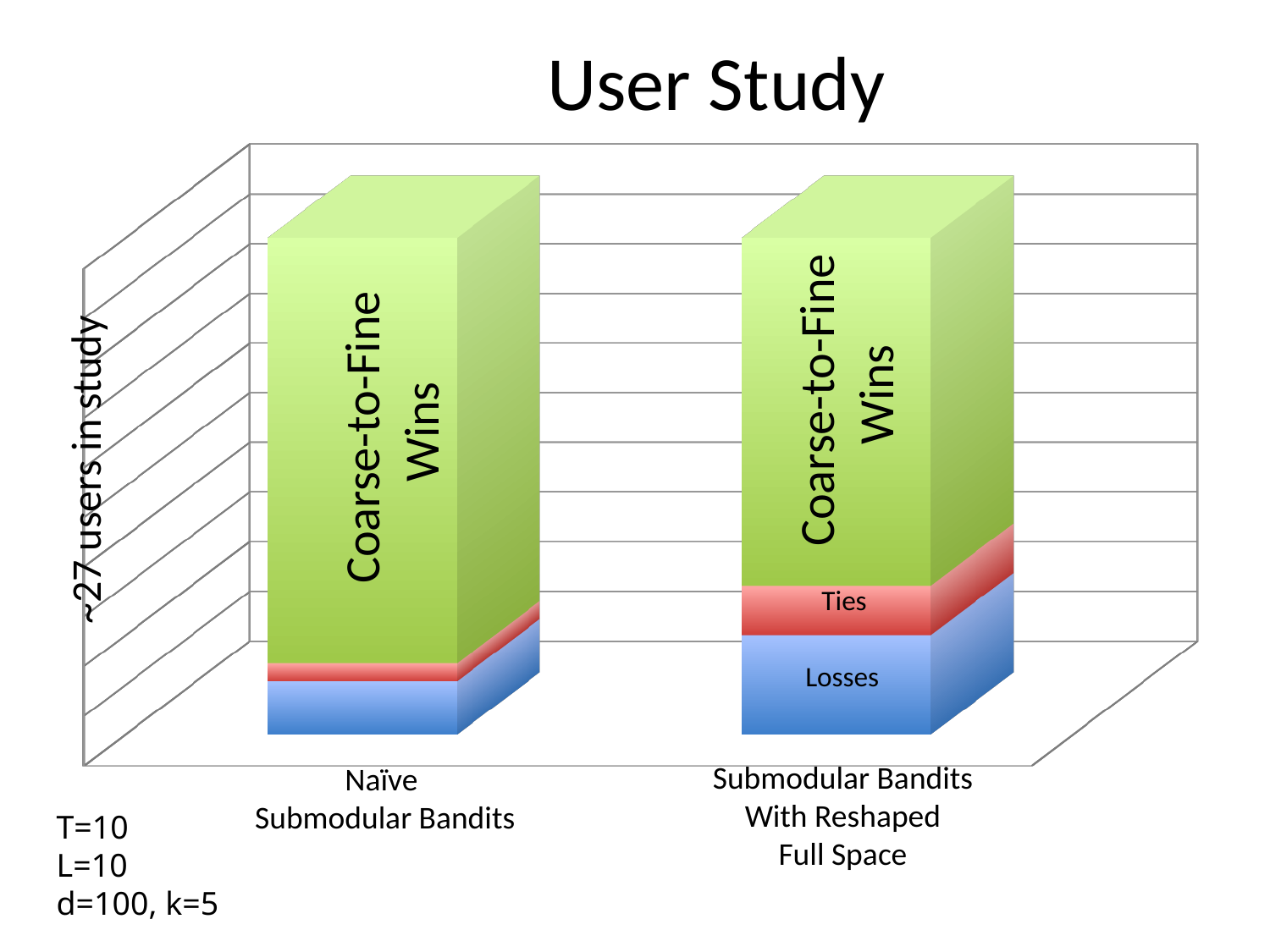
What are the names of the three segments in each stacked bar? Coarse-to-Fine Wins, Ties, Losses Which category has the larger 'Ties' segment, Naïve Submodular Bandits or Submodular Bandits With Reshaped Full Space? Submodular Bandits With Reshaped Full Space Which segment is the smallest within the Submodular Bandits With Reshaped Full Space bar? Ties How many segments make up each stacked bar? 3 What is the title of the chart? User Study Which segment is the largest within the Naïve Submodular Bandits bar? Coarse-to-Fine Wins Which segment is the smallest within the Naïve Submodular Bandits bar? Ties What kind of chart is shown on the slide? Stacked bar chart How many categories (bars) are shown on the x axis? 2 Which category has the larger 'Coarse-to-Fine Wins' segment, Naïve Submodular Bandits or Submodular Bandits With Reshaped Full Space? Naïve Submodular Bandits What is the label on the vertical axis of the chart? ~27 users in study Which category has the larger 'Losses' segment, Naïve Submodular Bandits or Submodular Bandits With Reshaped Full Space? Submodular Bandits With Reshaped Full Space